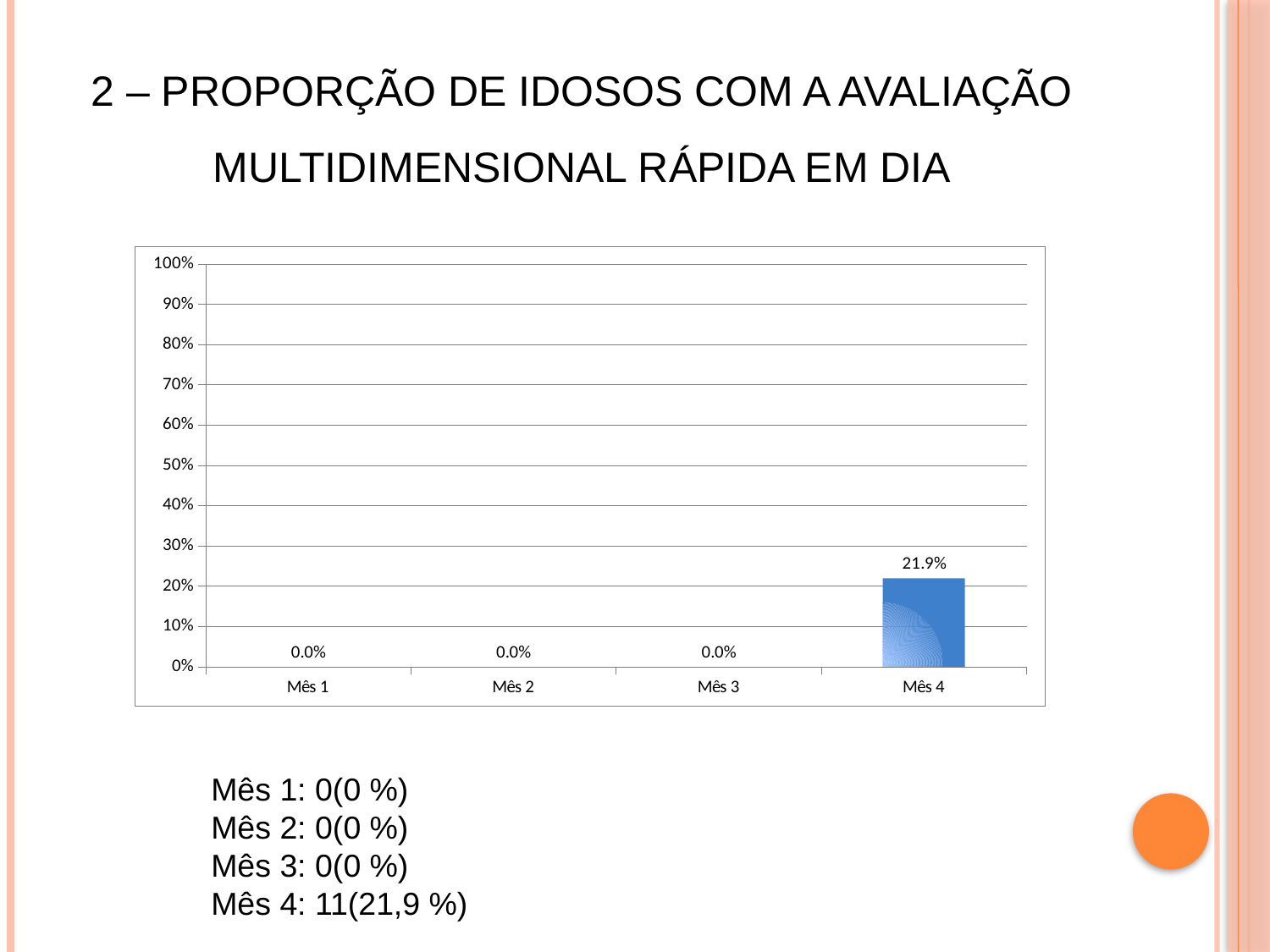
Is the value for Mês 4 greater or less than 10%? greater Which month has the highest value? Mês 4 What colour is the bar for Mês 4? blue What is the value for Mês 4? 21.9% What is the maximum value shown on the y axis? 100% How many categories are shown on the x axis? 4 What is the value for Mês 3? 0.0% Which is larger, the value for Mês 4 or the value for Mês 3? Mês 4 What is the difference between the values for Mês 4 and Mês 2? 21.9% What is the value for Mês 1? 0.0% Is the value for Mês 4 greater or less than 30%? less What kind of chart is shown on the slide? bar chart